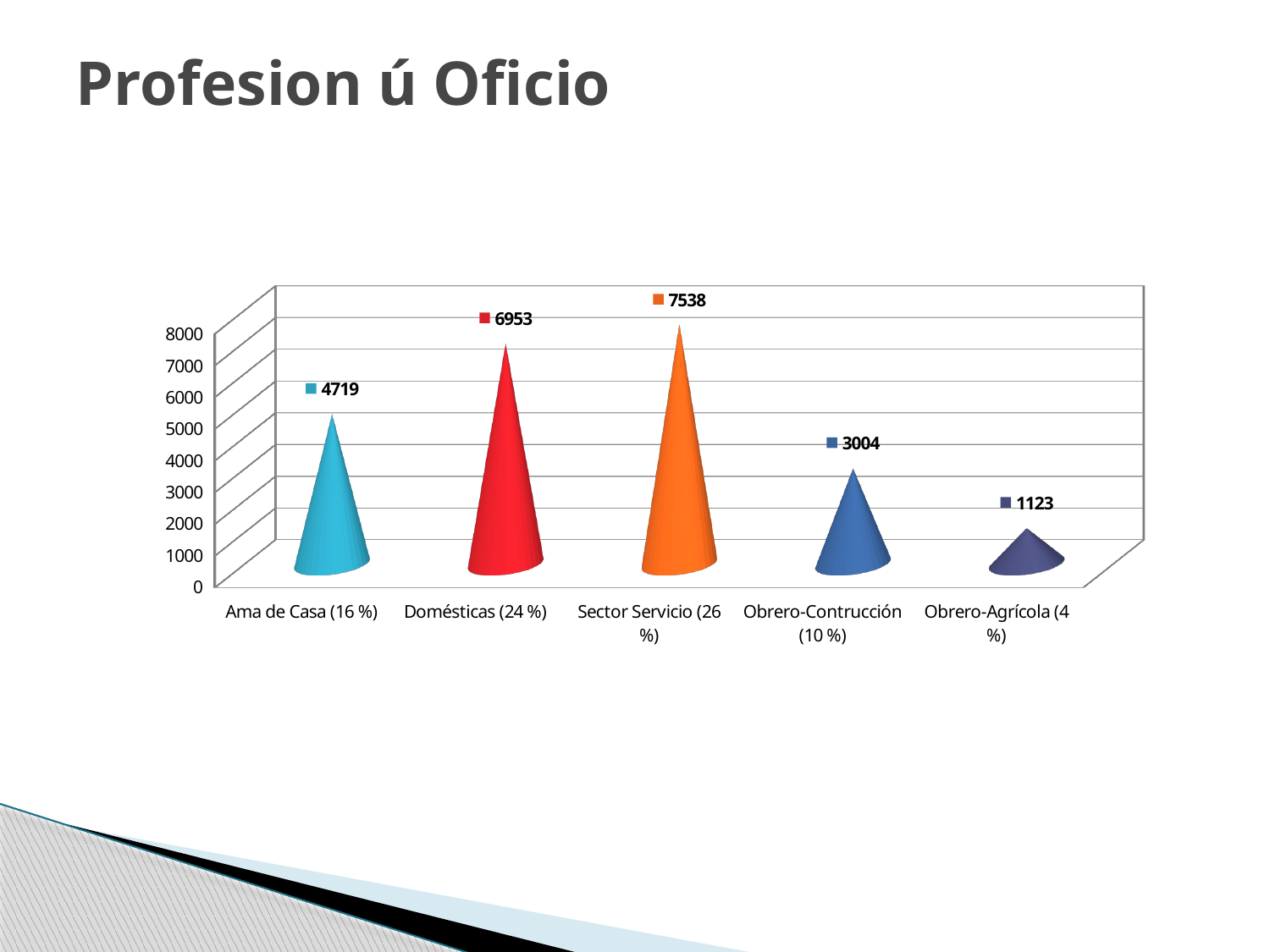
What is the value for Domésticas (24 %)? 6953 What is the value for Ama de Casa (16 %)? 4719 How many categories are shown on the x axis? 5 Which is larger, the value for Ama de Casa (16 %) or the value for Obrero-Contrucción (10 %)? Ama de Casa (16 %) What is the title of the slide containing the chart? Profesion ú Oficio What is the value for Obrero-Agrícola (4 %)? 1123 What is the difference between the values for Sector Servicio (26 %) and Domésticas (24 %)? 585 What kind of chart is shown on the slide? Bar chart What is the value for Sector Servicio (26 %)? 7538 Which category has the lowest value? Obrero-Agrícola (4 %) Which category has the highest value? Sector Servicio (26 %) What is the value for Obrero-Contrucción (10 %)? 3004